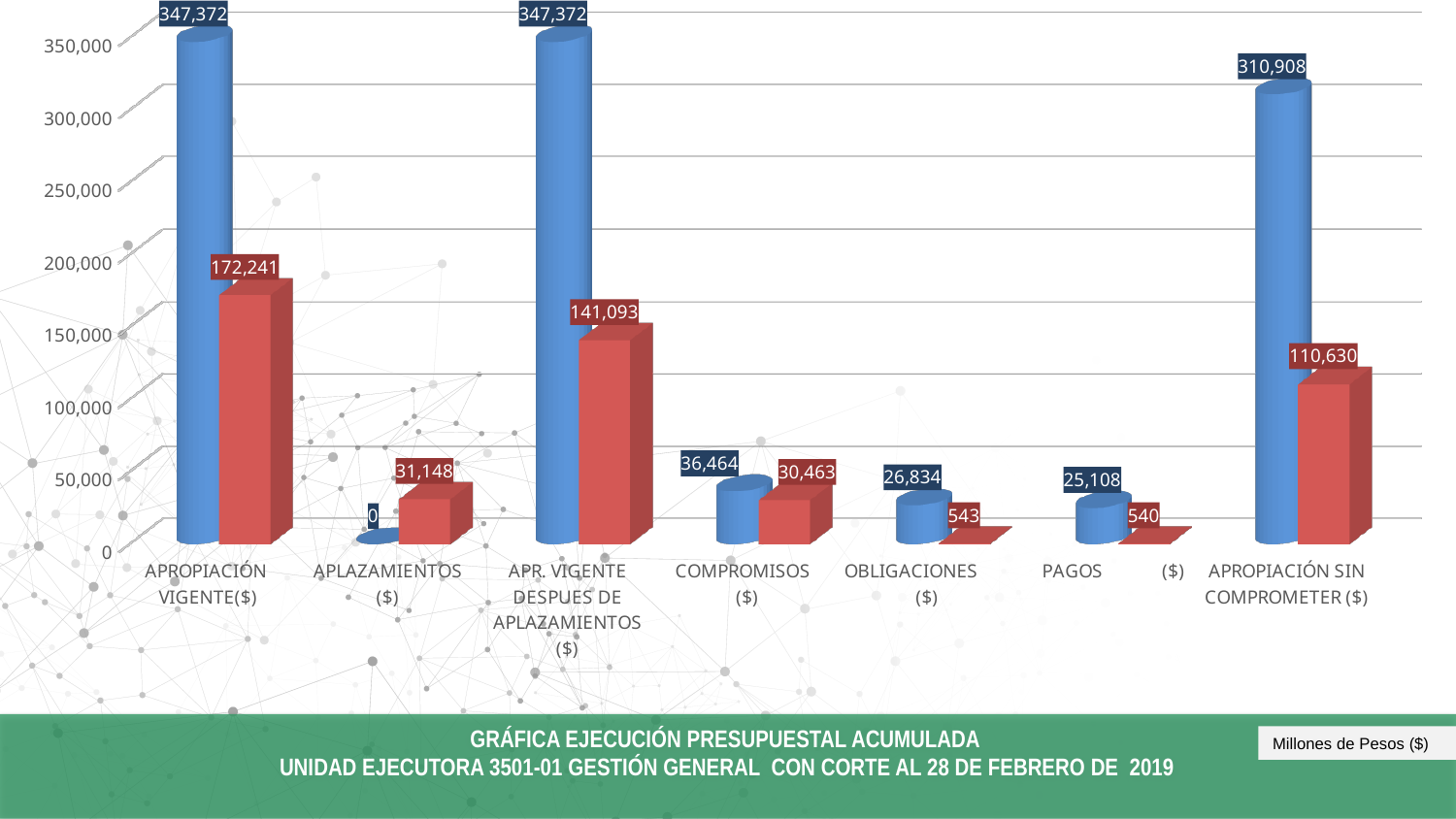
Which is larger, the blue bar for COMPROMISOS ($) or the blue bar for OBLIGACIONES ($)? COMPROMISOS ($) What is the value of the blue bar for APROPIACIÓN VIGENTE($)? 347,372 What is the value of the red bar for OBLIGACIONES ($)? 543 Which category has the lowest blue bar? APLAZAMIENTOS ($) What is the difference between the blue bar and the red bar for APROPIACIÓN VIGENTE($)? 175,131 What is the difference between the red bar for COMPROMISOS ($) and the red bar for OBLIGACIONES ($)? 29,920 Which category has the highest red bar? APROPIACIÓN VIGENTE($) What is the value of the blue bar for APROPIACIÓN SIN COMPROMETER ($)? 310,908 How many categories are shown on the x axis? 7 What kind of chart is shown on the slide? bar chart Is the red bar for APR. VIGENTE DESPUES DE APLAZAMIENTOS ($) greater or less than 150,000? less What is the value of the red bar for COMPROMISOS ($)? 30,463